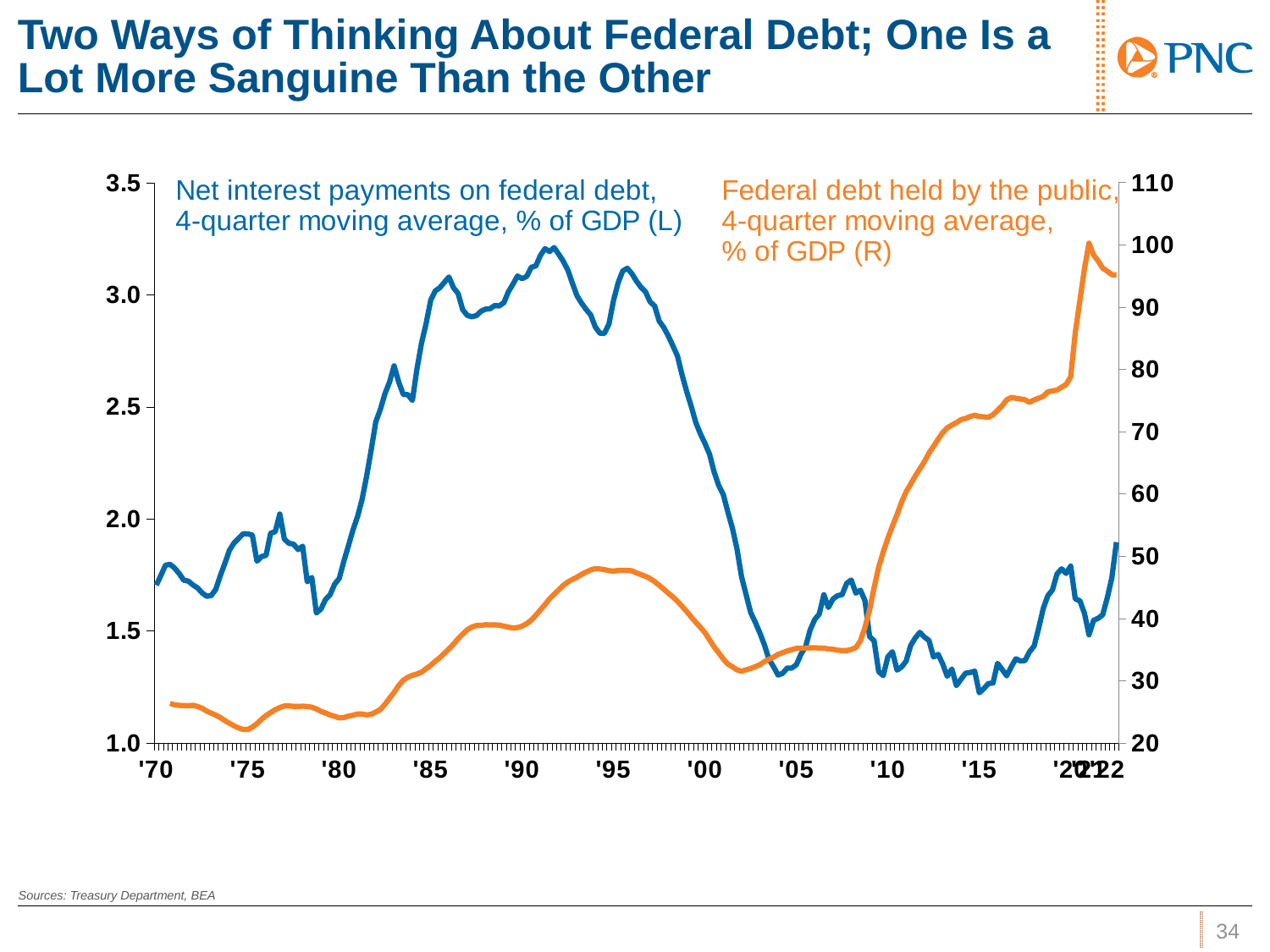
How many data series are plotted on the chart? 2 Which axis, left or right, is used for the federal debt held by the public series? Right Is the value of federal debt held by the public (orange line) around 1975 greater or less than 30? less What kind of chart is shown on the slide? Line chart Is the value of net interest payments on federal debt (blue line) around 1980 greater or less than 2.0? less Is the value of net interest payments on federal debt (blue line) around 2015 greater or less than 1.5? less Does the federal debt held by the public (orange line) rise or fall between 2010 and 2020? rise What is the title of the slide? Two Ways of Thinking About Federal Debt; One Is a Lot More Sanguine Than the Other Do net interest payments on federal debt (blue line) rise or fall between the early 1990s and the early 2000s? fall